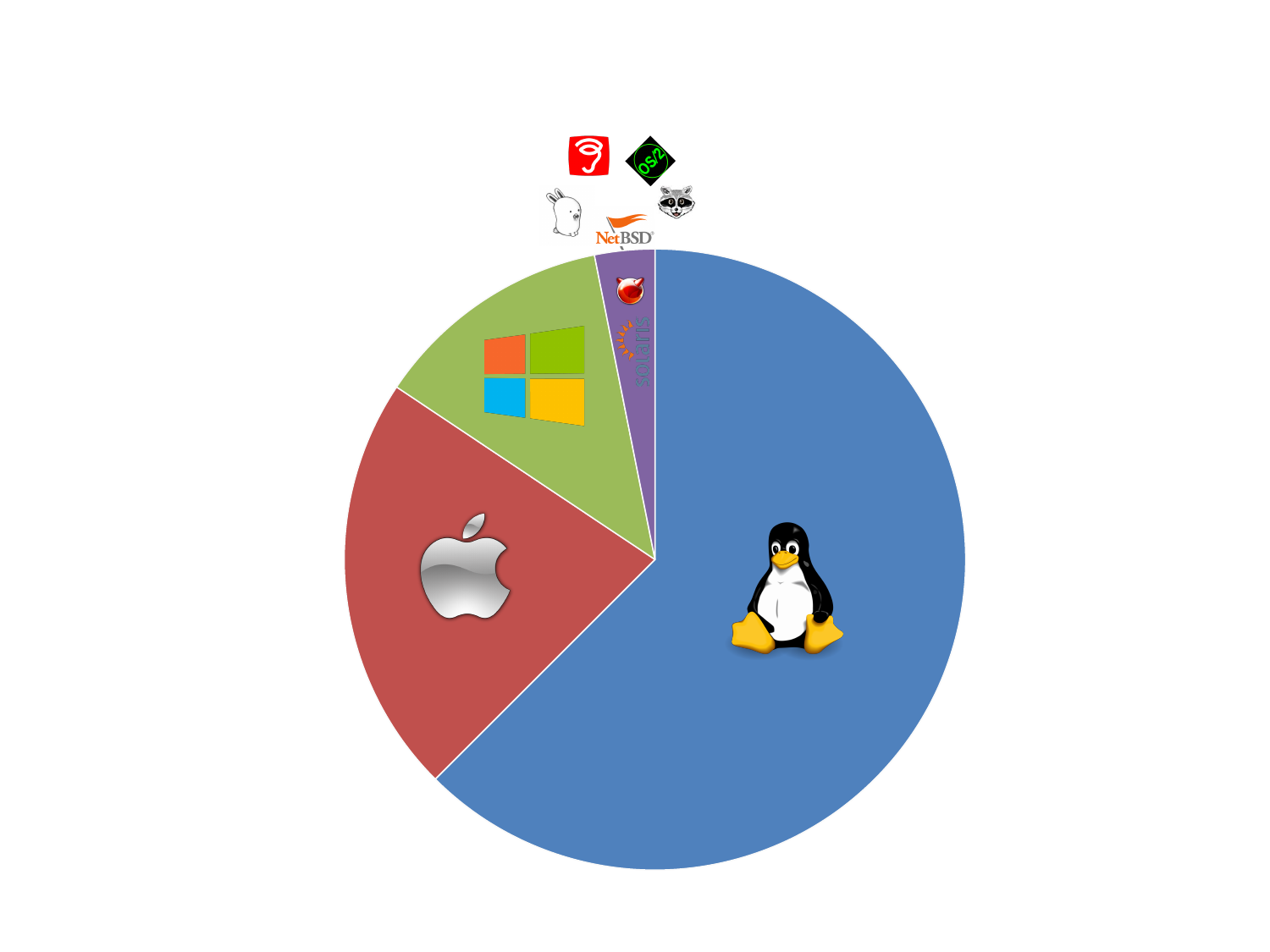
What kind of chart is shown on the slide? pie chart Which is larger: the blue slice with the Linux penguin or the red slice with the Apple logo? the blue slice (Linux) Which is larger: the red slice with the Apple logo or the green slice with the Windows logo? the red slice (Apple) What colour is the slice containing the Linux penguin? blue Which is larger: the green slice with the Windows logo or the purple slice labelled Solaris? the green slice (Windows) What colour is the slice containing the Apple logo? red Does the blue Linux slice take up more or less than half of the pie? more Which slice of the pie chart is the largest? the blue slice (Linux penguin)